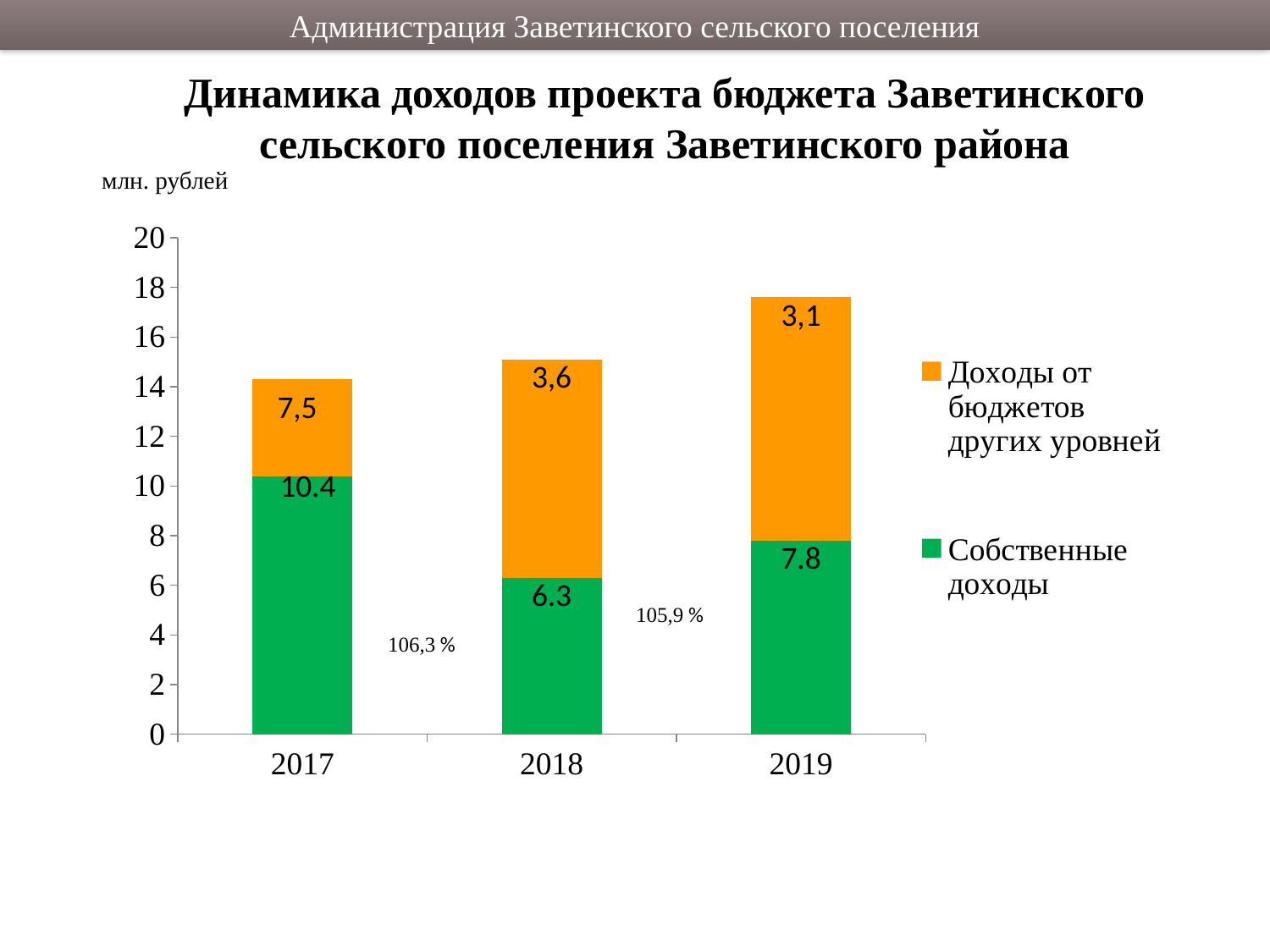
What is the data label for Доходы от бюджетов других уровней in 2018? 3,6 How many series does the legend list? 2 What is the data label for Доходы от бюджетов других уровней in 2017? 7,5 In which year is Собственные доходы the highest? 2017 What is the value of Собственные доходы for 2017? 10.4 What is the value of Собственные доходы for 2019? 7.8 What is the data label for Доходы от бюджетов других уровней in 2019? 3,1 How many years are shown on the x axis? 3 Is the value of Собственные доходы for 2018 greater or less than 8? less In which year is Собственные доходы the lowest? 2018 What type of chart is shown on the slide? stacked bar chart What is the value of Собственные доходы for 2018? 6.3